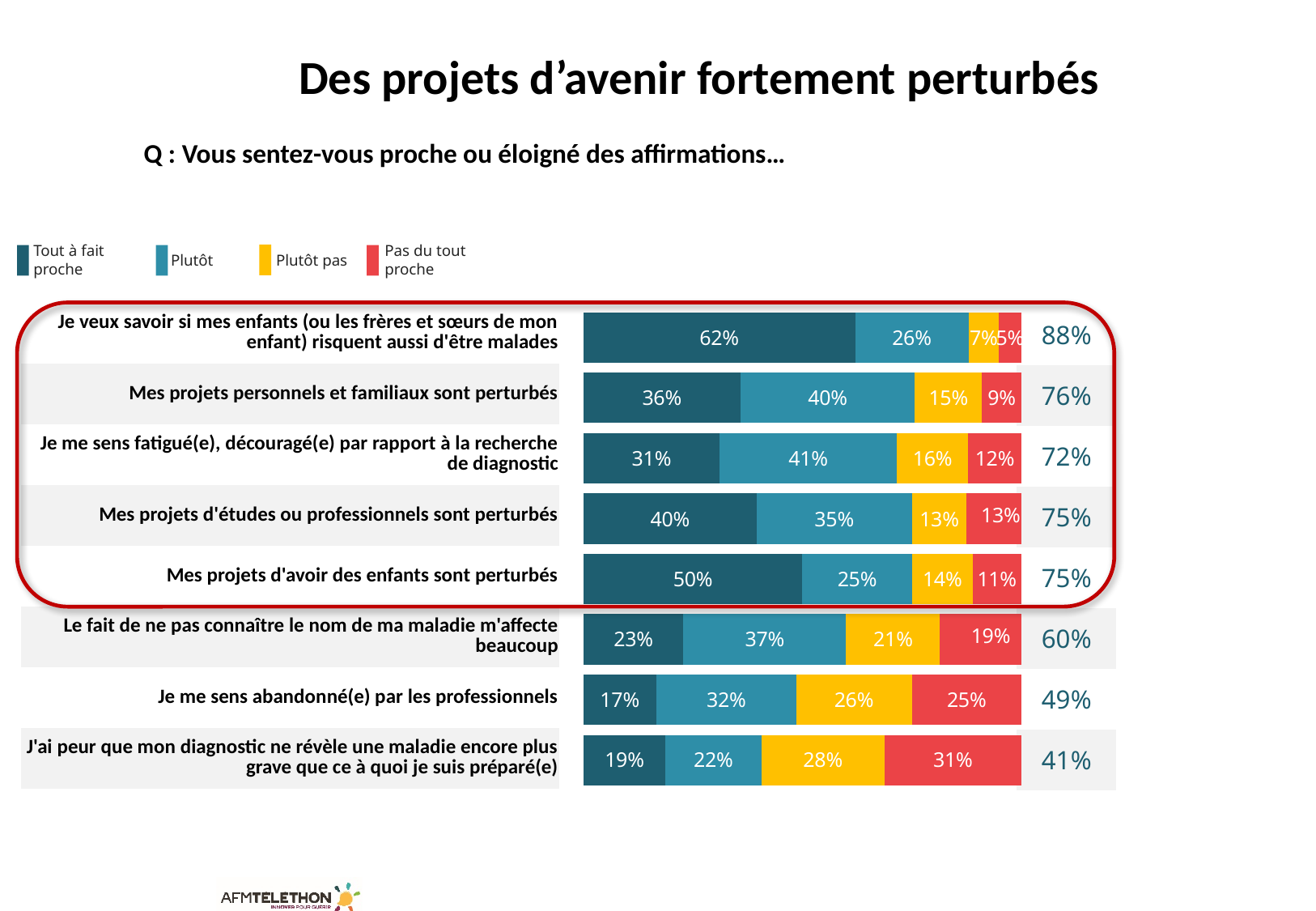
How many statements are plotted in the chart? 8 How many series does the legend list? 4 What percentage of respondents answered "Tout à fait proche" for "Mes projets d'avoir des enfants sont perturbés"? 50% What kind of chart is shown on the slide? Stacked bar chart What is the difference between the "Plutôt pas" values for "Je me sens abandonné(e) par les professionnels" and "Mes projets d'études ou professionnels sont perturbés"? 13% Which is larger: the "Pas du tout proche" value for "Le fait de ne pas connaître le nom de ma maladie m'affecte beaucoup" or for "Mes projets personnels et familiaux sont perturbés"? Le fait de ne pas connaître le nom de ma maladie m'affecte beaucoup Which statement has the lowest "Tout à fait proche" percentage? Je me sens abandonné(e) par les professionnels What is the "Plutôt" value for "Je me sens fatigué(e), découragé(e) par rapport à la recherche de diagnostic"? 41% What is the combined total of "Tout à fait proche" and "Plutôt" for "Mes projets personnels et familiaux sont perturbés"? 76% What percentage answered "Pas du tout proche" for "J'ai peur que mon diagnostic ne révèle une maladie encore plus grave que ce à quoi je suis préparé(e)"? 31% Which statement has the highest "Tout à fait proche" percentage? Je veux savoir si mes enfants (ou les frères et sœurs de mon enfant) risquent aussi d'être malades Which colour represents "Plutôt pas" in the legend? Yellow